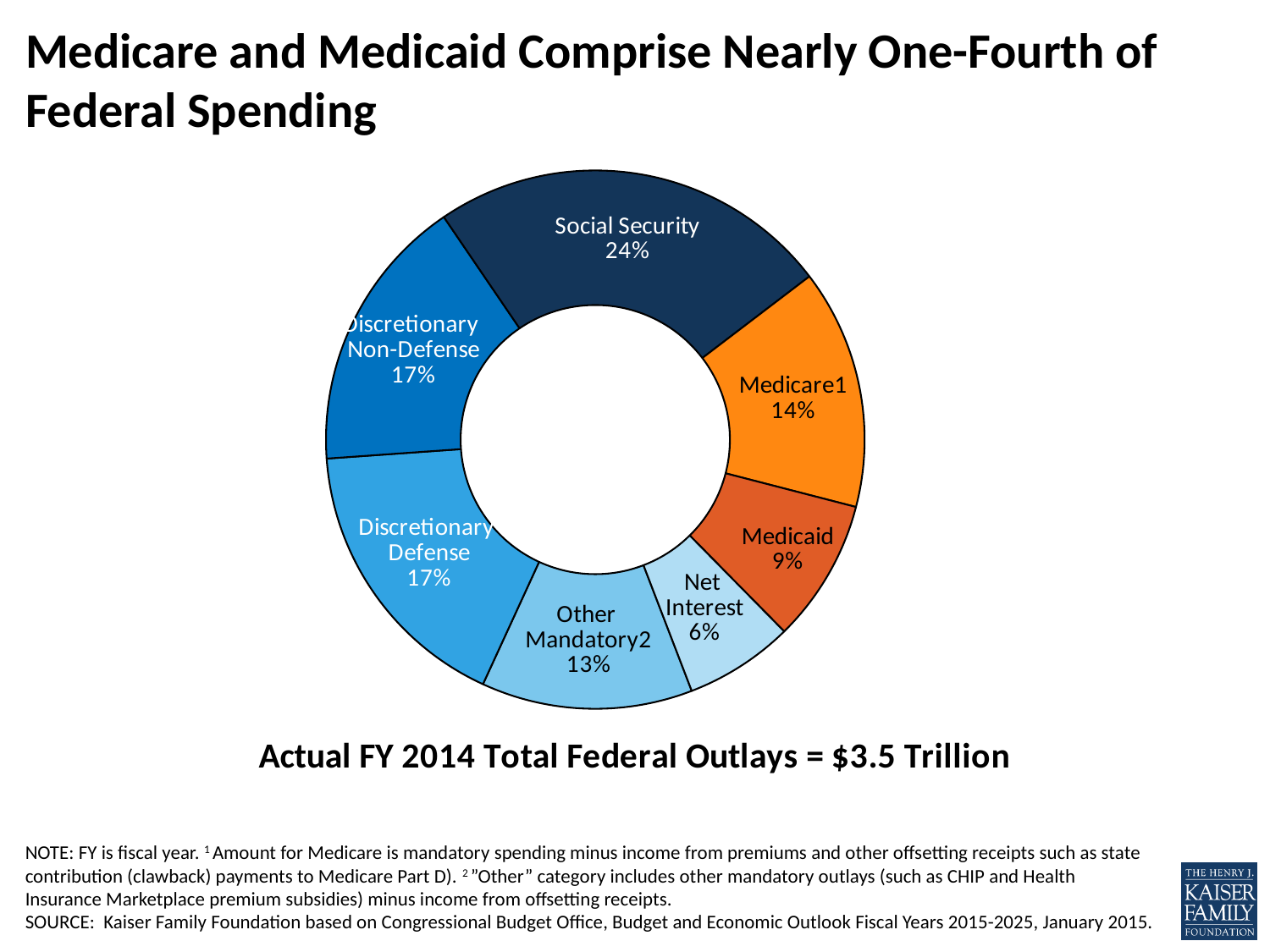
What kind of chart is shown on the slide? Pie chart (donut) What is the combined share of Medicare and Medicaid? 23% What percentage is shown for Other Mandatory? 13% Which category has the largest share of federal spending? Social Security How many categories are shown in the chart? 7 What share of federal spending does Social Security account for? 24% Which category has the smallest share of federal spending? Net Interest What is the difference in percentage points between Medicare and Medicaid? 5 What percentage of federal outlays goes to Medicaid? 9% What total federal outlays amount is stated below the chart? $3.5 Trillion What is the value shown for Net Interest? 6% Which is larger, the share for Medicare or the share for Other Mandatory? Medicare